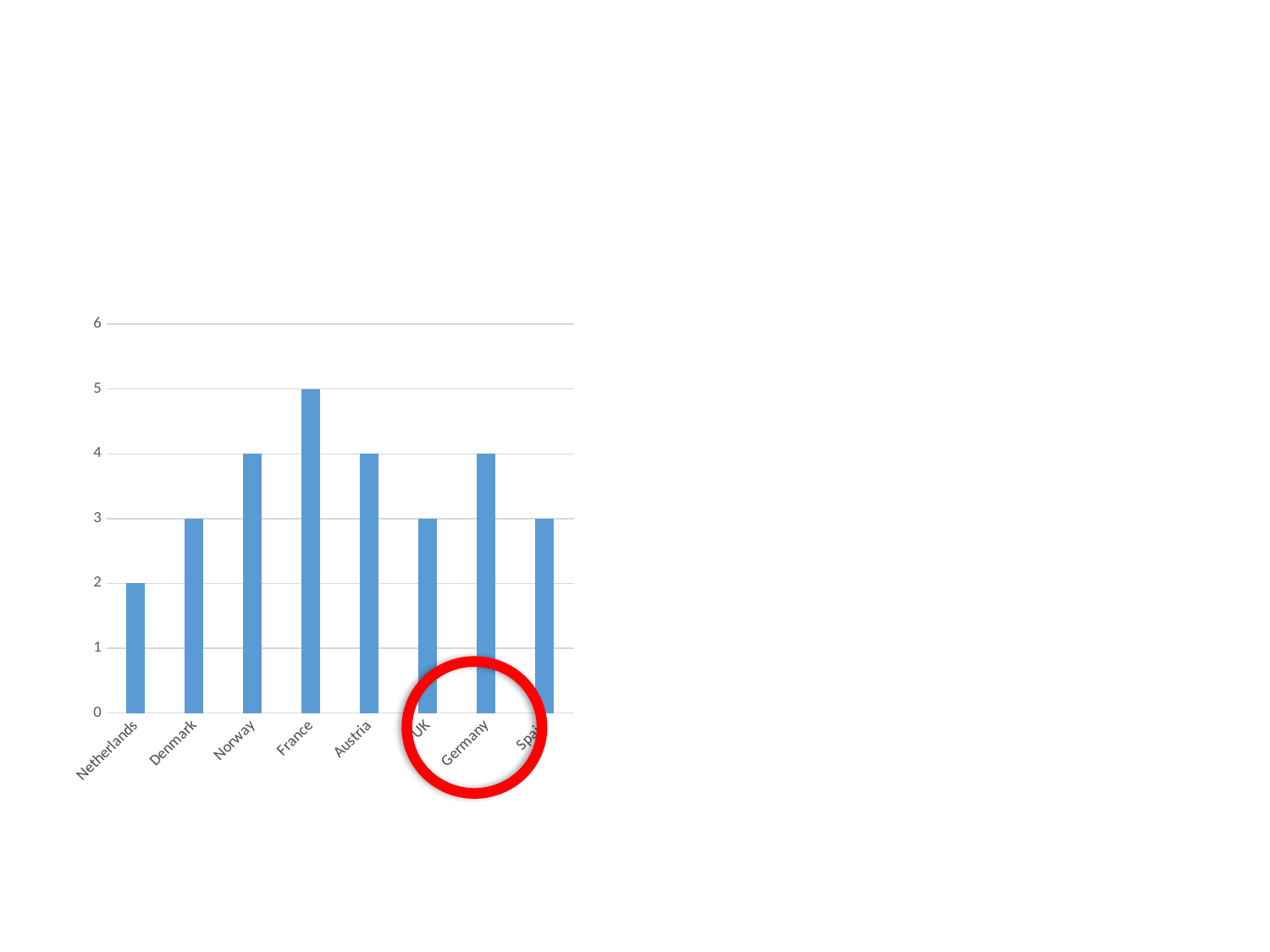
What is the value for Netherlands? 2 Which is larger, the value for Norway or the value for UK? Norway Which country has the lowest bar? Netherlands What is the value for France? 5 What type of chart is shown on the slide? Bar chart Is the value for Austria greater or less than 3? greater What is the difference between the values for France and Netherlands? 3 What is the value for Denmark? 3 Which country has the highest bar? France How many countries are shown on the x axis? 8 Which country label on the x axis is circled in red? Germany What is the value for Germany? 4